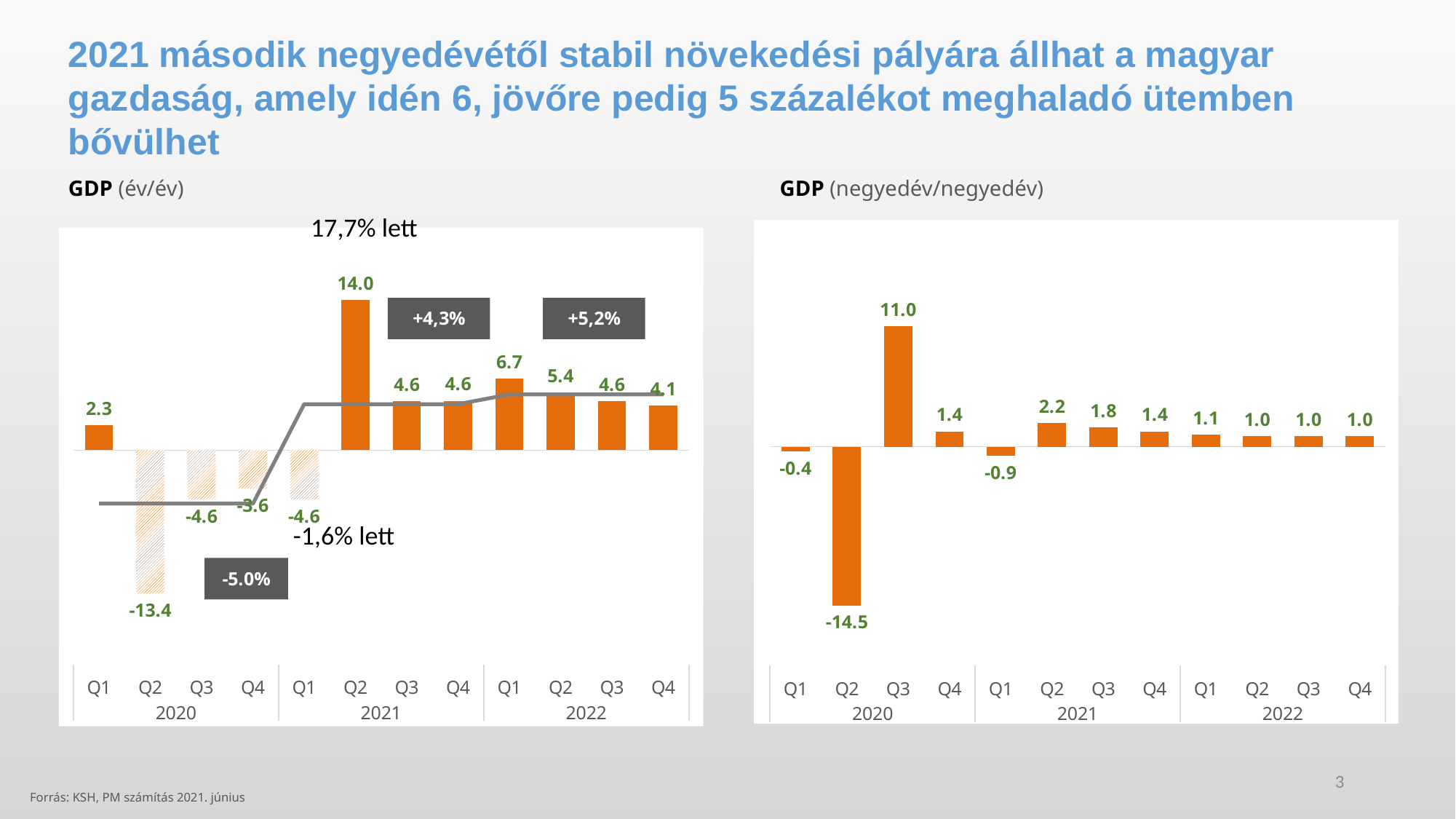
In the GDP (év/év) chart, what is the difference between the Q1 2022 value and the Q2 2022 value? 1.3 In the GDP (negyedév/negyedév) chart, which quarter has the highest value? Q3 2020 In the GDP (negyedév/negyedév) chart, do the values rise or fall from Q2 2021 to Q4 2022? Fall In the GDP (év/év) chart, what annual growth figure is shown in the dark box above the 2022 bars? +5,2% What kind of chart is the GDP (negyedév/negyedév) chart? Bar chart In the GDP (negyedév/negyedév) chart, what is the value for Q1 2021? -0.9 In the GDP (év/év) chart, which quarter has the lowest value? Q2 2020 In the GDP (negyedév/negyedév) chart, which is larger: the value for Q2 2021 or the value for Q3 2021? Q2 2021 In the GDP (negyedév/negyedév) chart, how many quarters are plotted? 12 In the GDP (év/év) chart, what is the value for Q2 2020? -13.4 In the GDP (negyedév/negyedév) chart, what is the value for Q3 2020? 11.0 In the GDP (év/év) chart, what is the value for Q2 2021? 14.0